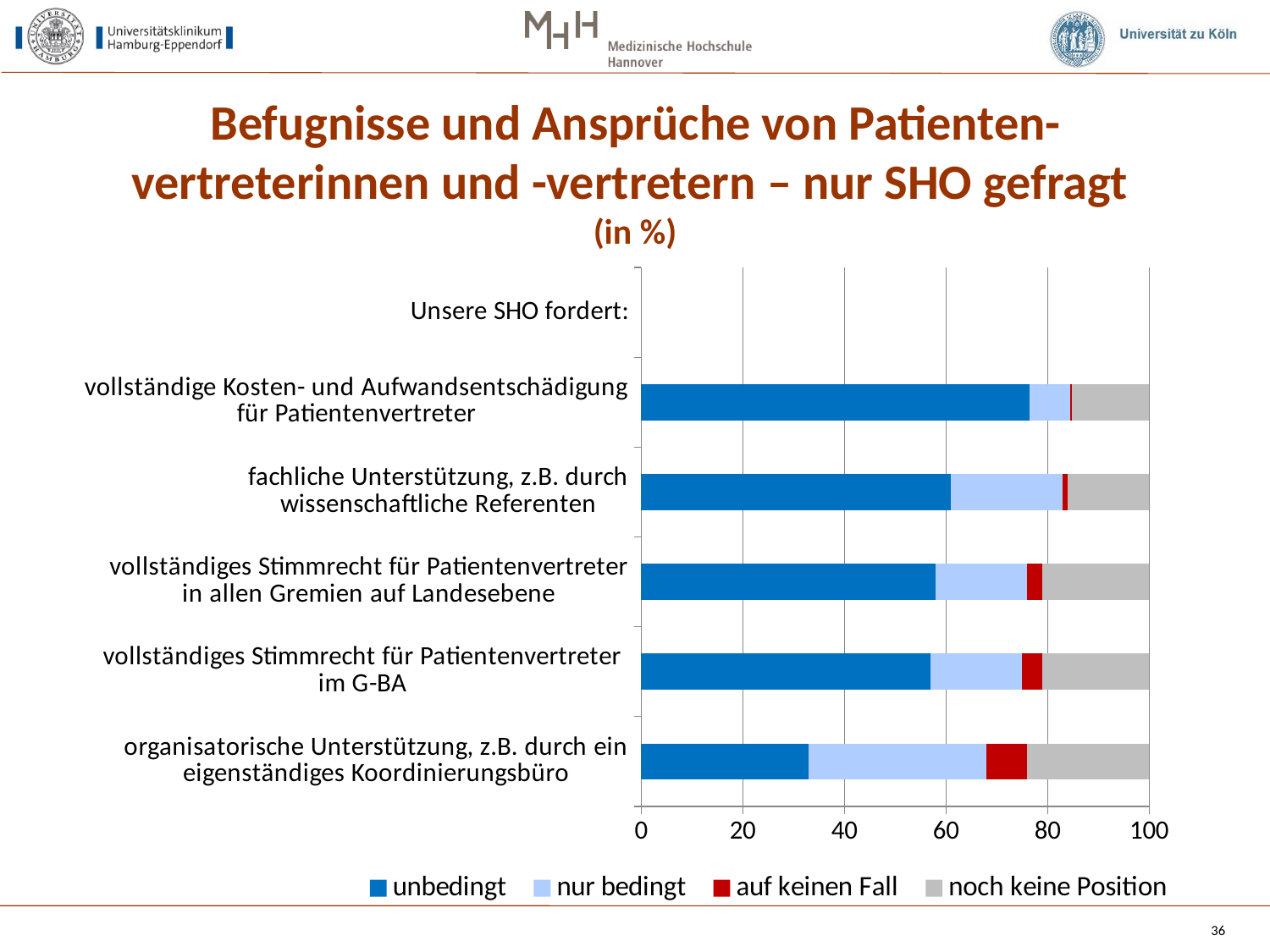
What is the maximum value shown on the x axis? 100 How many statements have bars plotted in the chart? 5 What kind of chart is shown on the slide? Stacked horizontal bar chart Is the 'unbedingt' value for 'vollständige Kosten- und Aufwandsentschädigung für Patientenvertreter' greater or less than 60? greater How many series does the legend list? 4 Which legend entry is shown in red? auf keinen Fall Which has the larger 'unbedingt' segment: 'fachliche Unterstützung, z.B. durch wissenschaftliche Referenten' or 'organisatorische Unterstützung, z.B. durch ein eigenständiges Koordinierungsbüro'? fachliche Unterstützung, z.B. durch wissenschaftliche Referenten Which statement has the largest 'unbedingt' segment? vollständige Kosten- und Aufwandsentschädigung für Patientenvertreter Which statement has the smallest 'unbedingt' segment? organisatorische Unterstützung, z.B. durch ein eigenständiges Koordinierungsbüro Which statement has the largest 'auf keinen Fall' segment? organisatorische Unterstützung, z.B. durch ein eigenständiges Koordinierungsbüro Is the 'unbedingt' value for 'fachliche Unterstützung, z.B. durch wissenschaftliche Referenten' greater or less than 80? less Is the 'unbedingt' value for 'organisatorische Unterstützung, z.B. durch ein eigenständiges Koordinierungsbüro' greater or less than 40? less